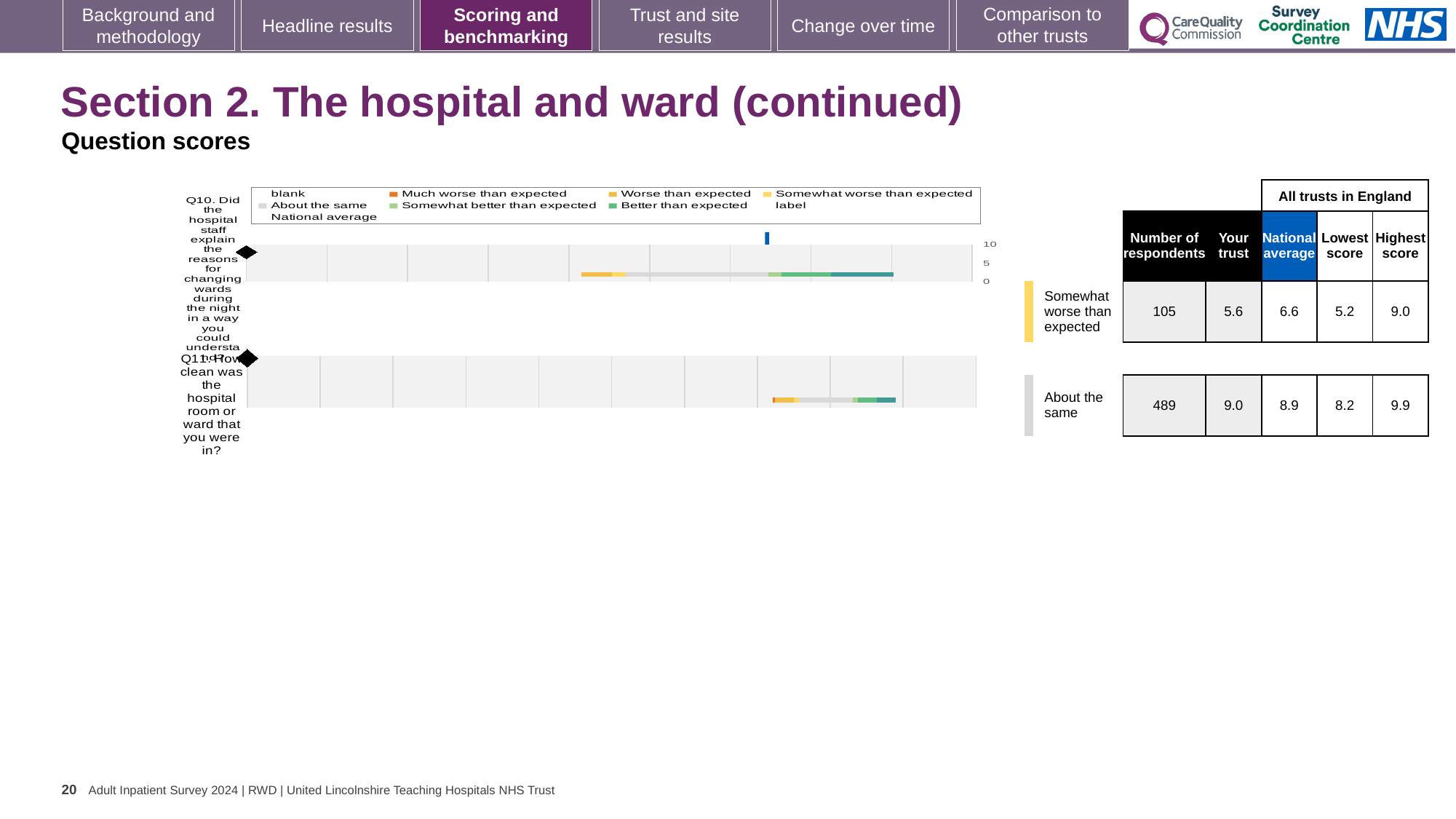
What is the national average score for Q10? 6.6 What is the difference between the highest and lowest scores for Q10 across all trusts in England? 3.8 What is the 'Your trust' score for Q11? 9.0 Which benchmark category is Q10 placed in? Somewhat worse than expected How many respondents answered Q11 (how clean was the hospital room or ward)? 489 What kind of chart is used to show the question scores on this slide? Bar chart What is the highest score among all trusts in England for Q11? 9.9 How many questions are plotted in the chart? 2 What is the maximum value shown on the score axis of the chart? 10 What is the 'Your trust' score for Q10 (explaining reasons for changing wards during the night)? 5.6 For Q10, which is larger: the trust's score or the national average? National average Which question has the higher 'Your trust' score, Q10 or Q11? Q11